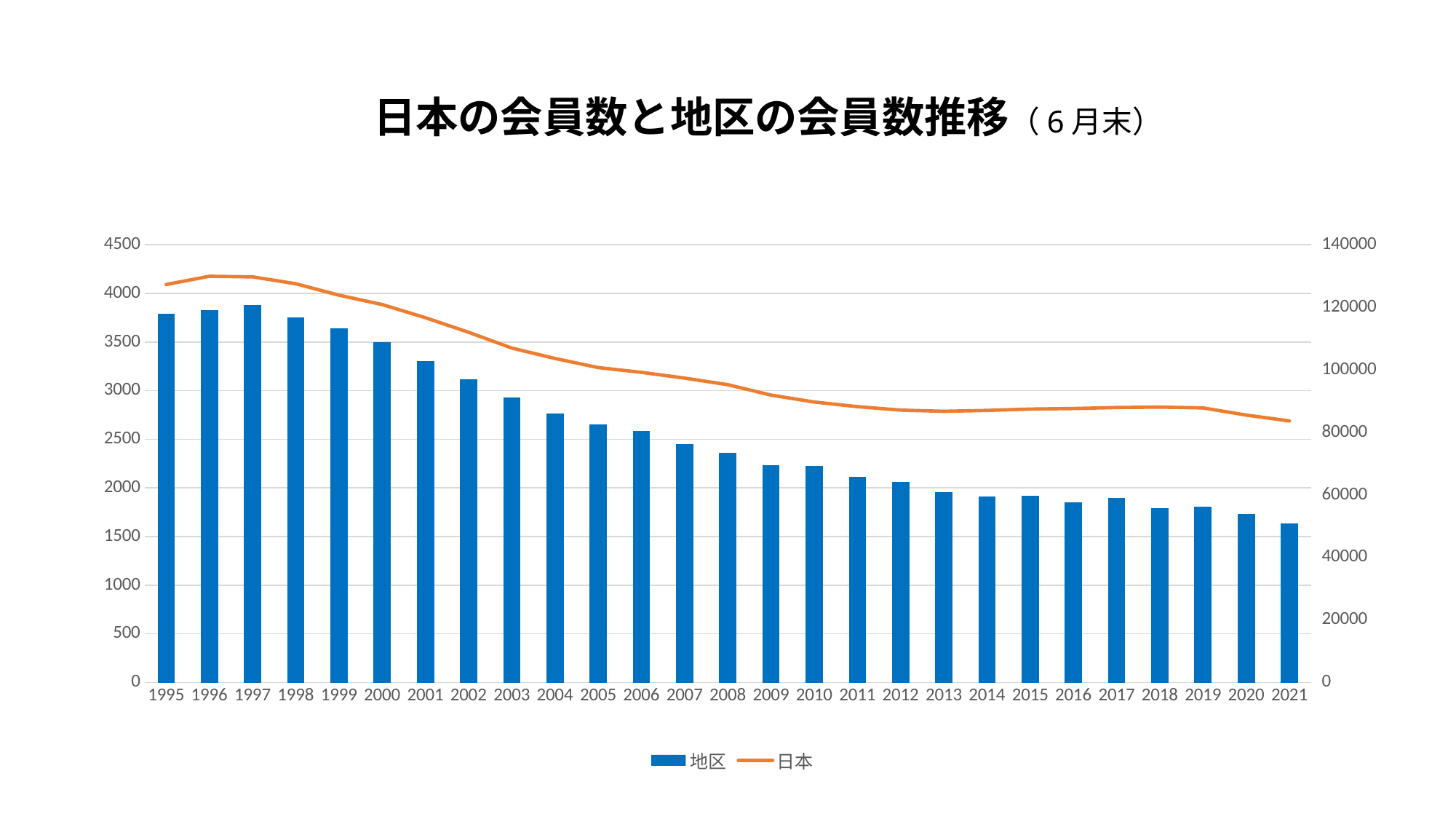
Is the 地区 value for 1995 greater or less than 3500? greater Is the 地区 value for 2003 greater or less than 3000? less Is the 地区 value for 2021 greater or less than 2000? less Which year has the lowest value on the 日本 line? 2021 What kind of chart is shown on the slide? A combined bar and line chart Which year has the lowest bar for 地区? 2021 How many years are shown on the x axis? 27 Which year has the highest bar for 地区? 1997 Do the 地区 values generally rise or fall from 1997 to 2021? fall How many series does the legend list? 2